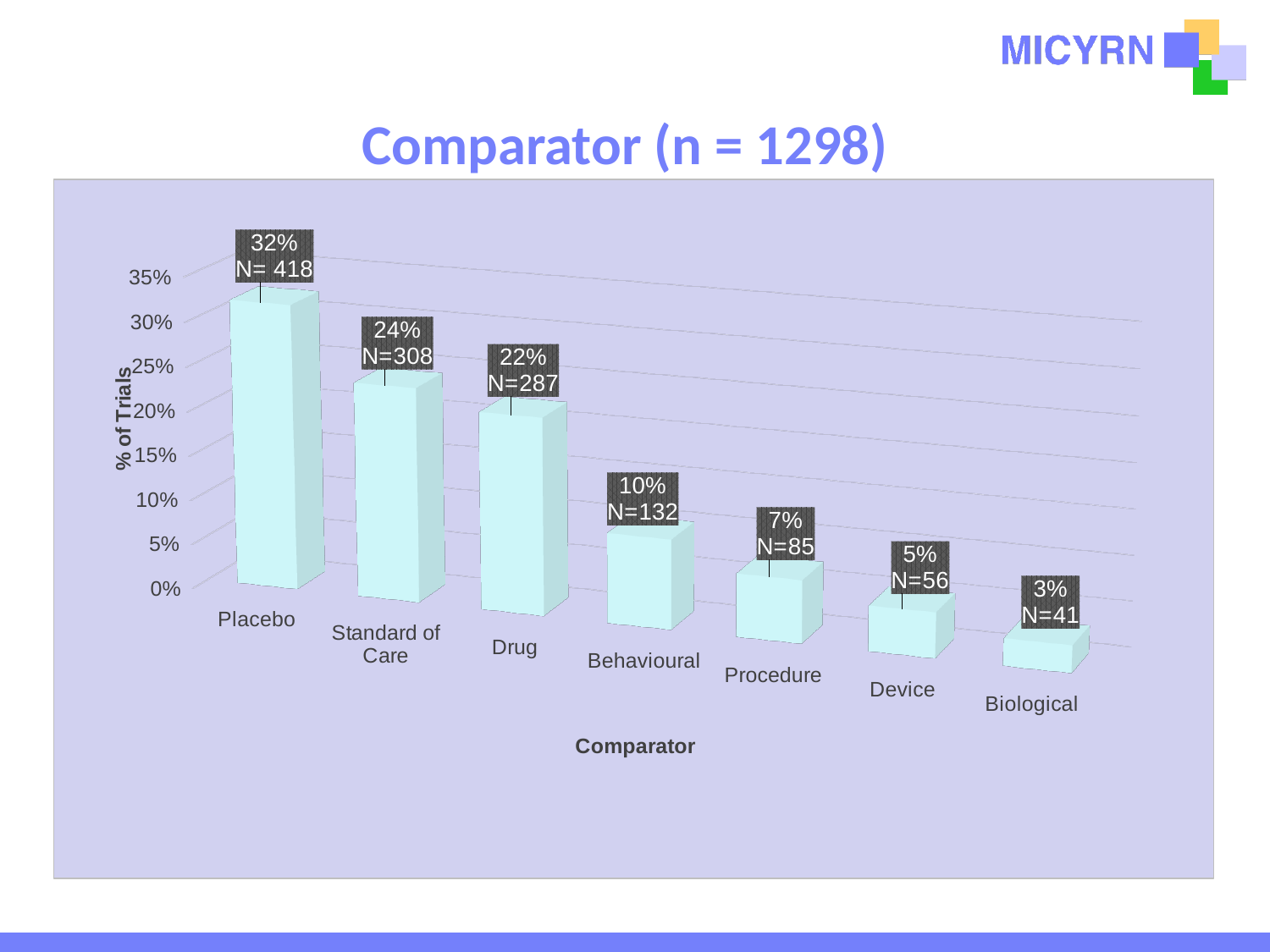
Which comparator category has the highest percentage of trials? Placebo Which has a larger percentage of trials, Procedure or Device? Procedure What is the difference in percentage points between Placebo and Drug? 10% How many trials (N) used Standard of Care as the comparator? 308 Which comparator category has the lowest percentage of trials? Biological What percentage of trials used Behavioural as the comparator? 10% How many comparator categories are shown on the x axis? 7 What kind of chart is shown on the slide? Bar chart What is the label of the y axis? % of Trials What percentage of trials used Placebo as the comparator? 32% Do the values rise or fall moving from left to right along the x axis? Fall What is the title of the chart? Comparator (n = 1298)